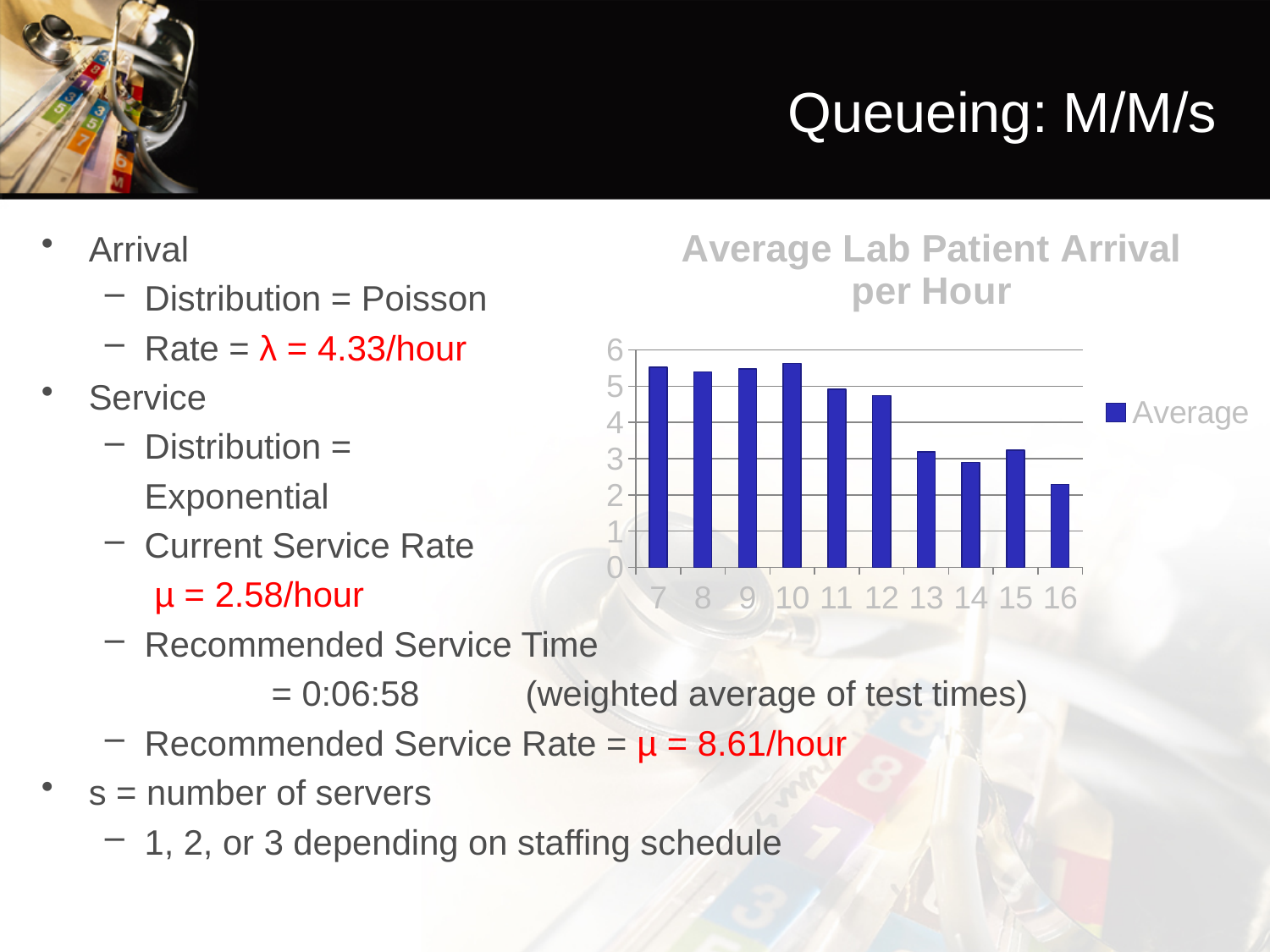
Is the value for hour 12 greater or less than 4? greater What is the name of the series shown in the chart legend? Average Which hour has the lowest average lab patient arrival? 16 What type of chart is shown on the slide? bar chart How many hour categories are plotted on the x axis of the chart? 10 Is the value for hour 16 greater or less than 3? less Is the value for hour 7 greater or less than 5? greater Do the average arrivals generally rise or fall from hour 7 to hour 16? fall How many series does the chart legend list? 1 What is the title of the chart? Average Lab Patient Arrival per Hour Which hour has the larger average arrival, 11 or 13? 11